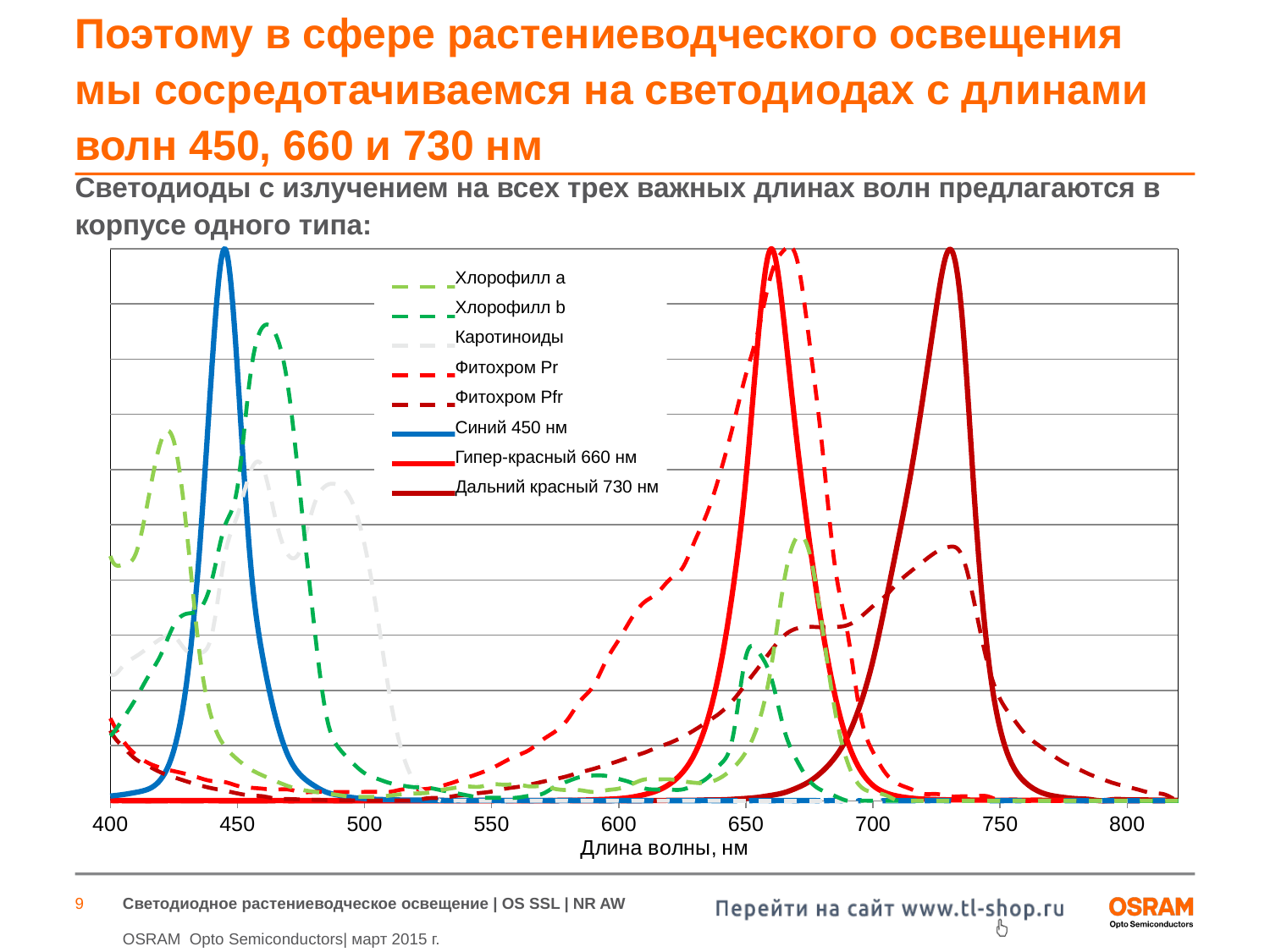
How many labelled tick marks are on the x axis? 9 Is the Хлорофилл a series drawn as a solid or a dashed line? dashed How many series does the chart legend list? 8 What is the title of the x axis of the chart? Длина волны, нм Which series peaks at a shorter wavelength in the blue region, Хлорофилл a or Хлорофилл b? Хлорофилл a Is the peak wavelength of the Гипер-красный 660 нм curve greater or less than 650? greater Which series peaks at a longer wavelength, Синий 450 нм or Дальний красный 730 нм? Дальний красный 730 нм What kind of chart is shown on the slide? line chart Which series peaks at a longer wavelength, Фитохром Pr or Фитохром Pfr? Фитохром Pfr Does the Синий 450 нм curve rise or fall between 450 and 500 nm? fall At what wavelength does the Дальний красный 730 нм curve reach its peak? 730